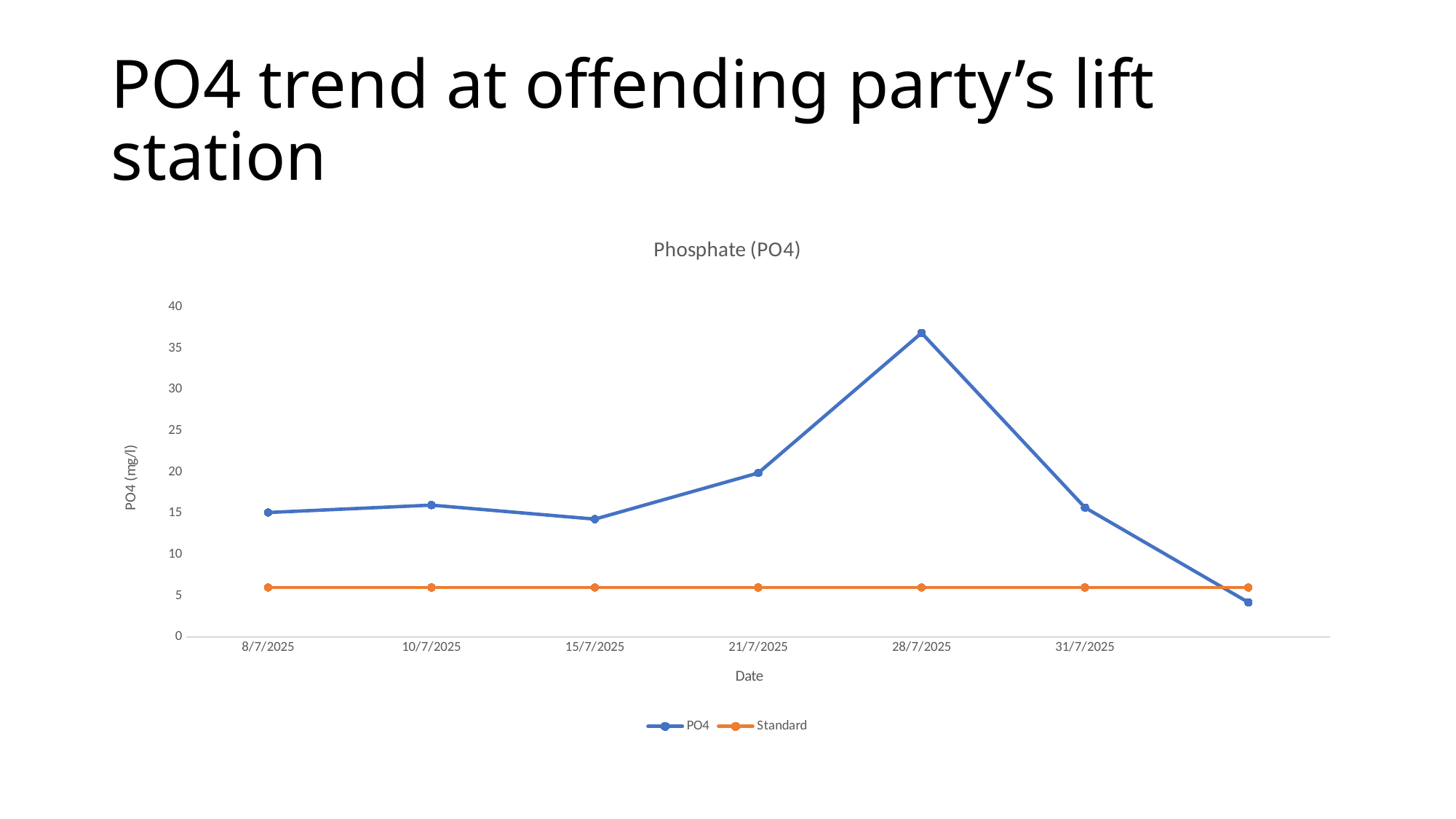
How many series does the legend list? 2 Is the PO4 value on 28/7/2025 greater or less than 35? greater Is the PO4 value on 21/7/2025 greater or less than 15? greater What is the title of the chart? Phosphate (PO4) On 21/7/2025, which series has the larger value, PO4 or Standard? PO4 What is the label on the vertical axis of the chart? PO4 (mg/l) Is the Standard value on 8/7/2025 greater or less than 10? less Does the PO4 series rise or fall between 28/7/2025 and 31/7/2025? fall What kind of chart is shown on the slide? line chart On which labelled date does the PO4 series reach its highest value? 28/7/2025 How many dates are labelled on the x axis? 6 Which is larger, the PO4 value on 28/7/2025 or the PO4 value on 8/7/2025? 28/7/2025